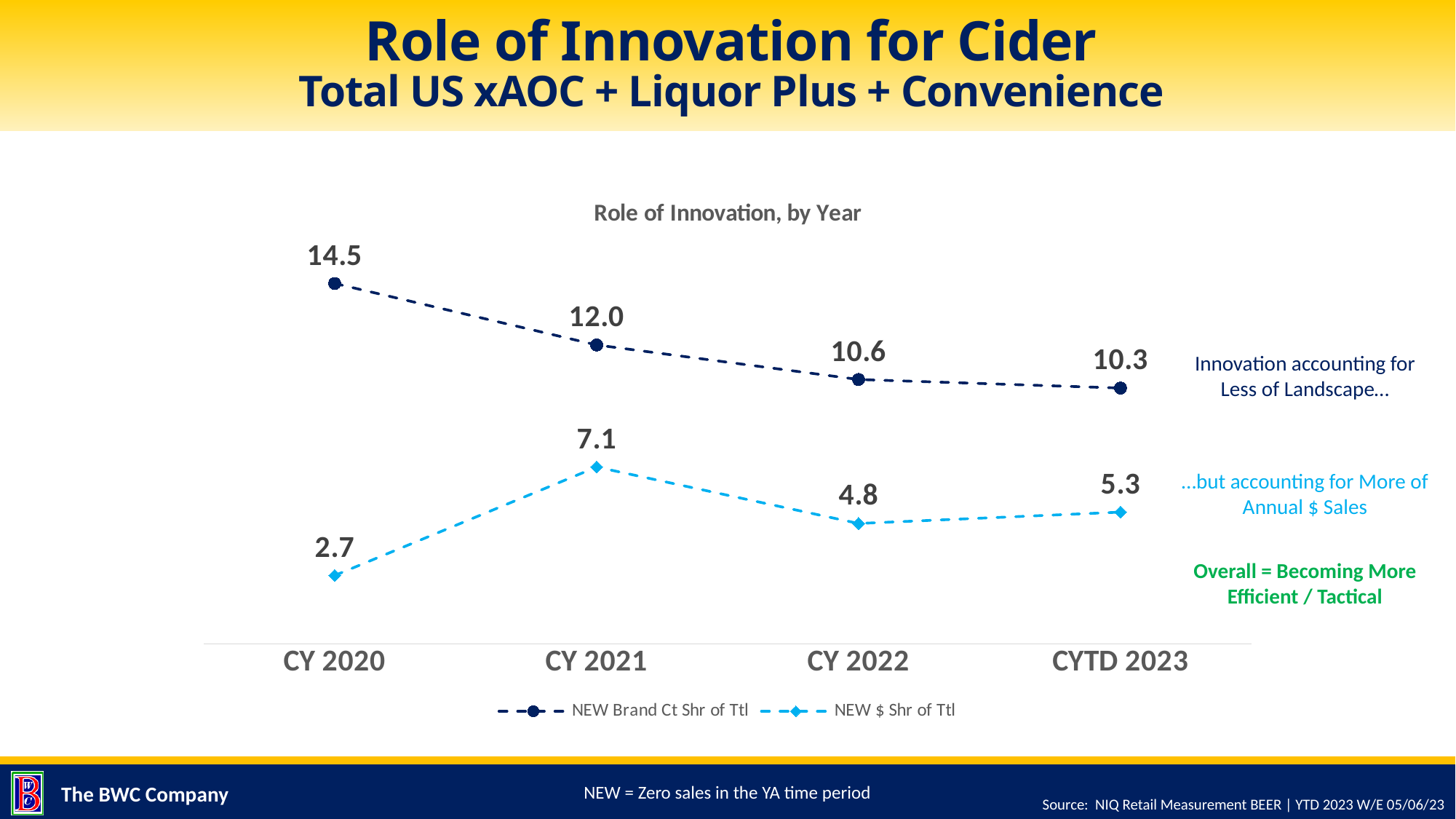
In which year is the NEW $ Shr of Ttl series highest? CY 2021 In which year is the NEW Brand Ct Shr of Ttl series lowest? CYTD 2023 Does the NEW Brand Ct Shr of Ttl series rise or fall from CY 2020 to CYTD 2023? Fall Which is larger in CY 2022: NEW Brand Ct Shr of Ttl or NEW $ Shr of Ttl? NEW Brand Ct Shr of Ttl What is the NEW Brand Ct Shr of Ttl value for CY 2022? 10.6 How many series does the legend list? 2 What is the NEW $ Shr of Ttl value for CY 2021? 7.1 What is the difference between the NEW Brand Ct Shr of Ttl values for CY 2020 and CYTD 2023? 4.2 What kind of chart is shown on the slide? Line chart What is the NEW $ Shr of Ttl value for CYTD 2023? 5.3 How many time periods are shown on the x axis? 4 What is the NEW Brand Ct Shr of Ttl value for CY 2020? 14.5